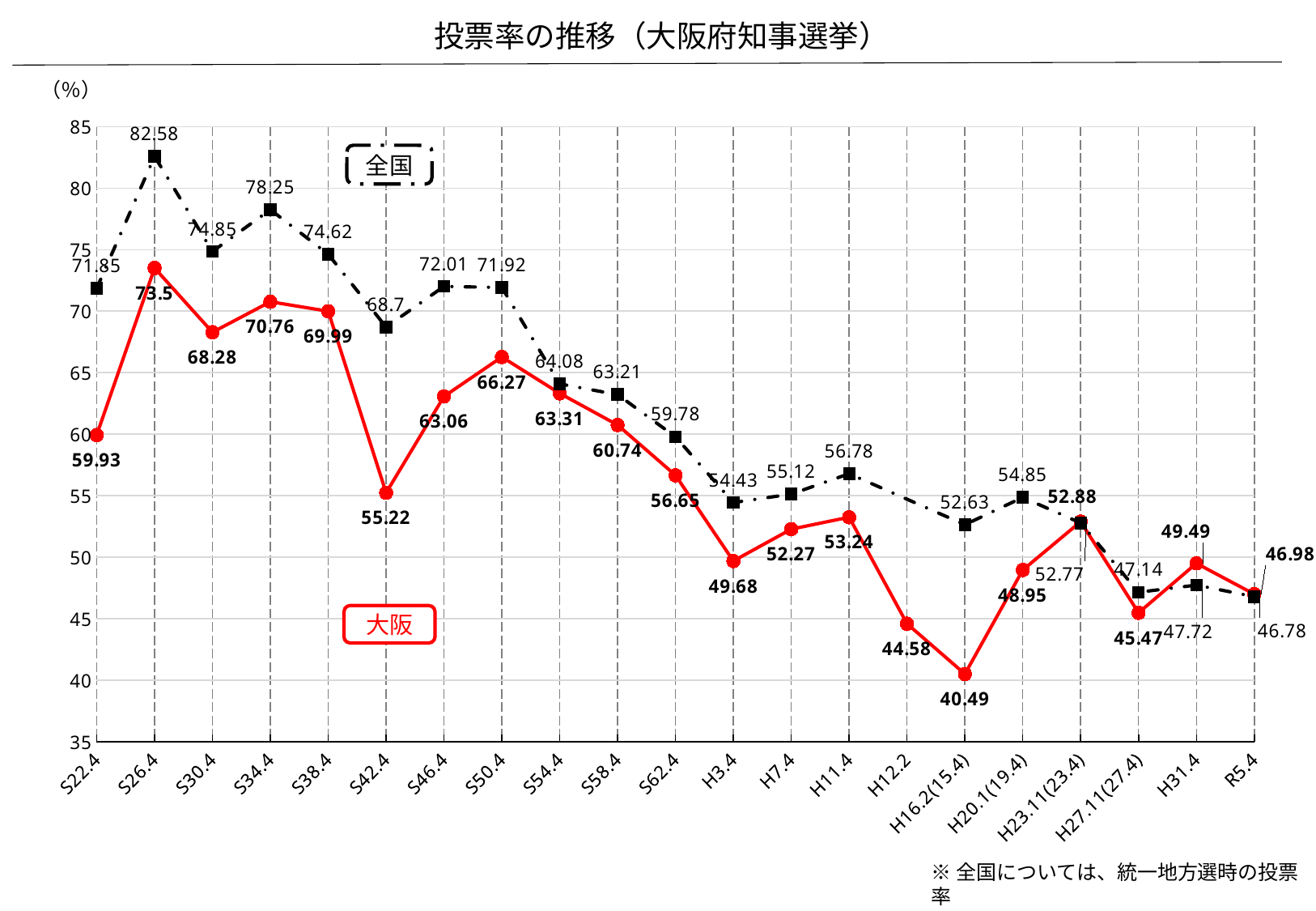
What is the Osaka (大阪) voter turnout at S42.4? 55.22 At S22.4, how much higher is the national (全国) turnout than the Osaka (大阪) turnout? 11.92 What is the Osaka (大阪) voter turnout at H12.2? 44.58 How many elections are shown on the x axis? 21 What kind of chart is this? line chart What is the national (全国) voter turnout at S26.4? 82.58 Does the Osaka (大阪) turnout generally rise or fall from S26.4 to H16.2(15.4)? fall In which election is the Osaka (大阪) turnout lowest? H16.2(15.4) Is the Osaka (大阪) turnout at H16.2(15.4) greater or less than 45? less How many series are plotted on the chart? 2 In which election is the Osaka (大阪) turnout highest? S26.4 At H3.4, which is larger: the Osaka (大阪) turnout or the national (全国) turnout? 全国 (national)